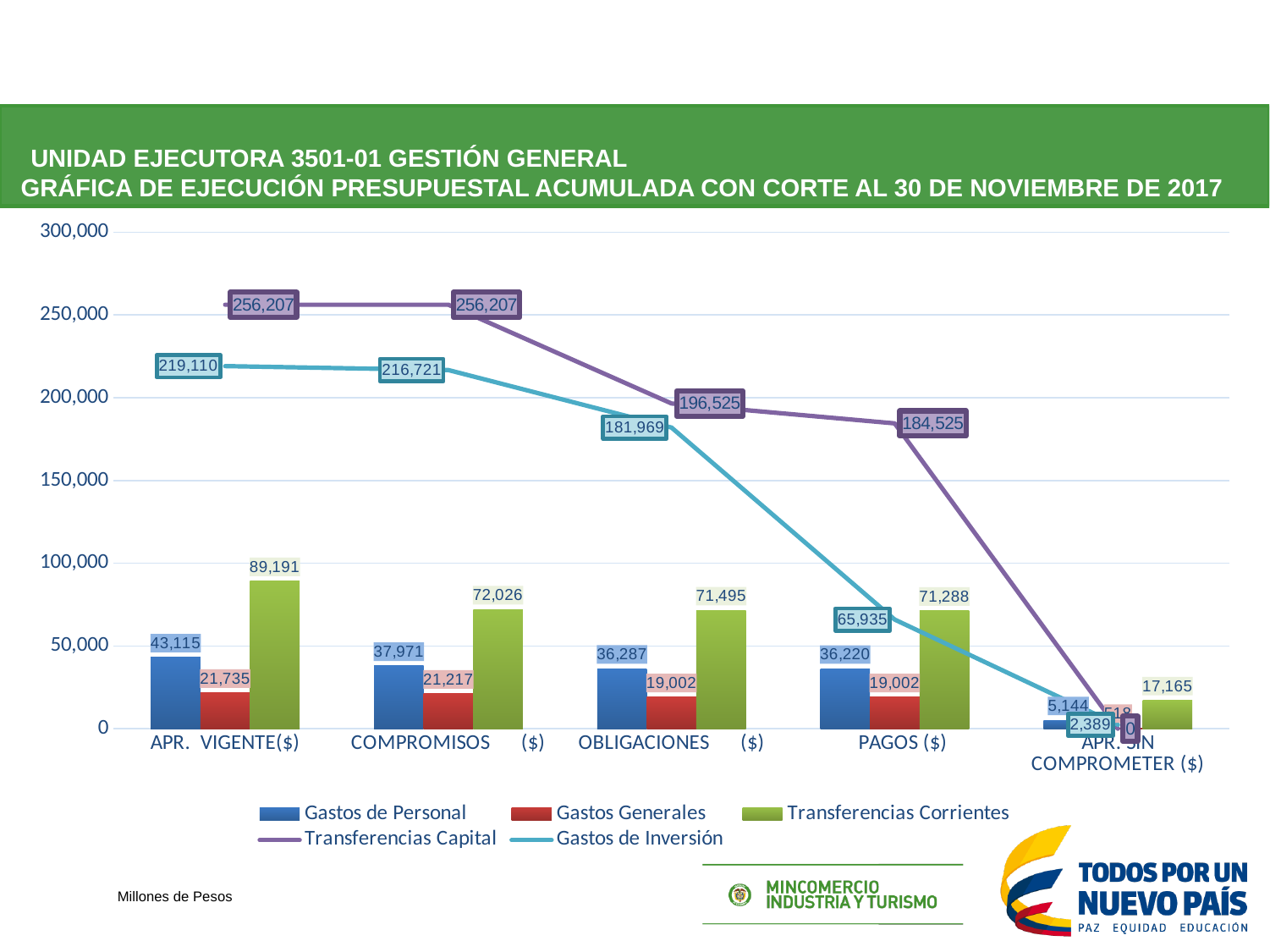
Does the Gastos de Inversión line rise or fall from APR. VIGENTE($) to APR. SIN COMPROMETER ($)? Fall How many series does the legend list? 5 What is the difference between the Gastos de Personal values for APR. VIGENTE($) and COMPROMISOS ($)? 5,144 What is the value of Transferencias Corrientes for APR. VIGENTE($)? 89,191 What is the value of Transferencias Capital for OBLIGACIONES ($)? 196,525 Which category has the lowest value for Transferencias Corrientes? APR. SIN COMPROMETER ($) What is the value of Gastos de Inversión for PAGOS ($)? 65,935 Which category has the highest value for Gastos de Personal? APR. VIGENTE($) How many categories are shown on the x axis? 5 What is the difference between the Transferencias Capital values for COMPROMISOS ($) and OBLIGACIONES ($)? 59,682 For APR. VIGENTE($), which is larger: Transferencias Capital or Gastos de Inversión? Transferencias Capital What kind of chart is this? Combination bar and line chart